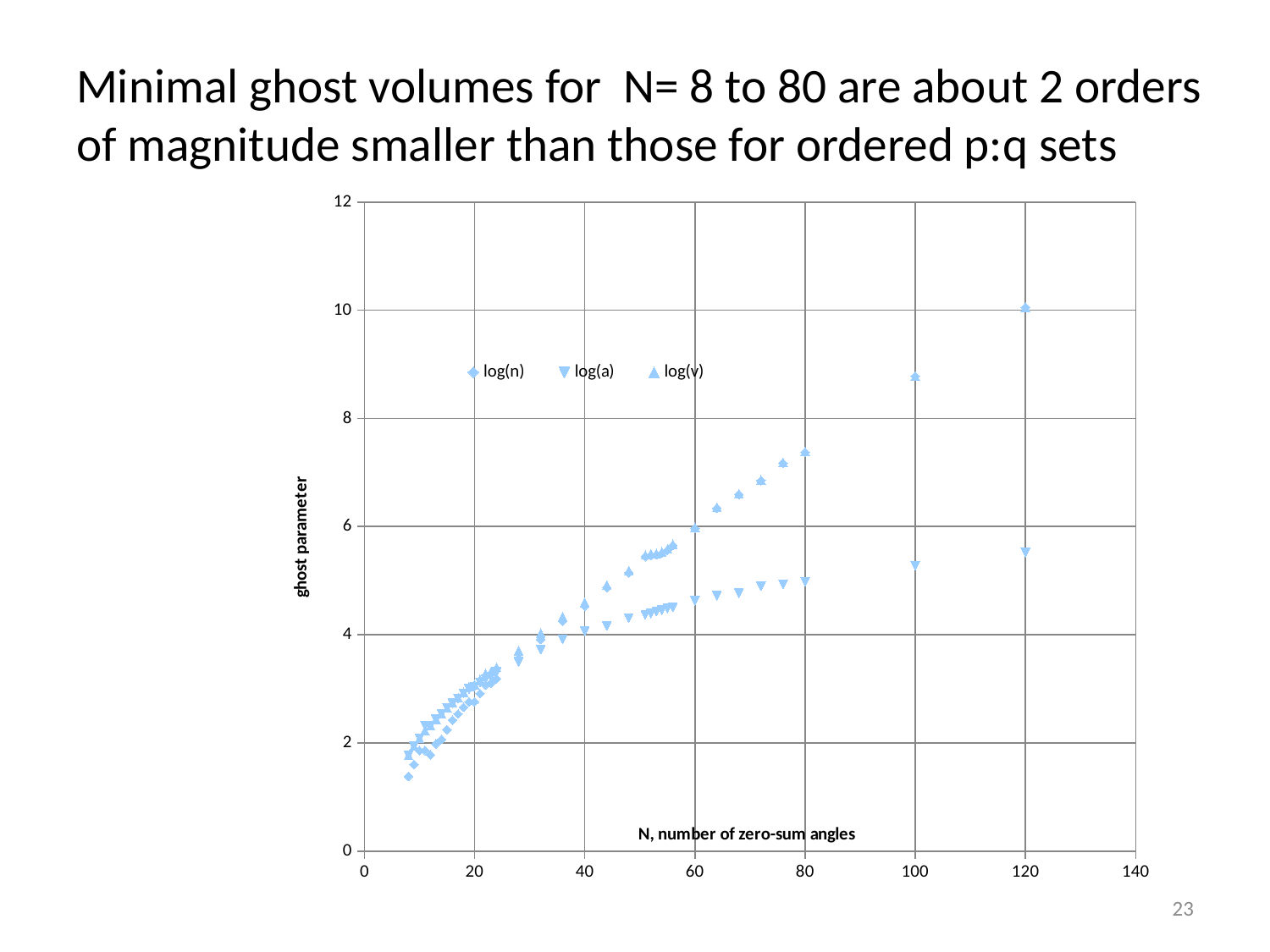
Is the log(v) value at N = 80 greater or less than 6? greater At N = 120, which series has the larger value, log(v) or log(a)? log(v) What is the title of the vertical axis of the chart? ghost parameter How many series does the chart legend list? 3 Do the log(v) values rise or fall as N increases along the x axis? rise Is the log(v) value at N = 100 greater or less than 8? greater What are the three series named in the chart legend? log(n), log(a), log(v) What kind of chart is shown on the slide? scatter chart Is the log(a) value at N = 100 greater or less than 4? greater